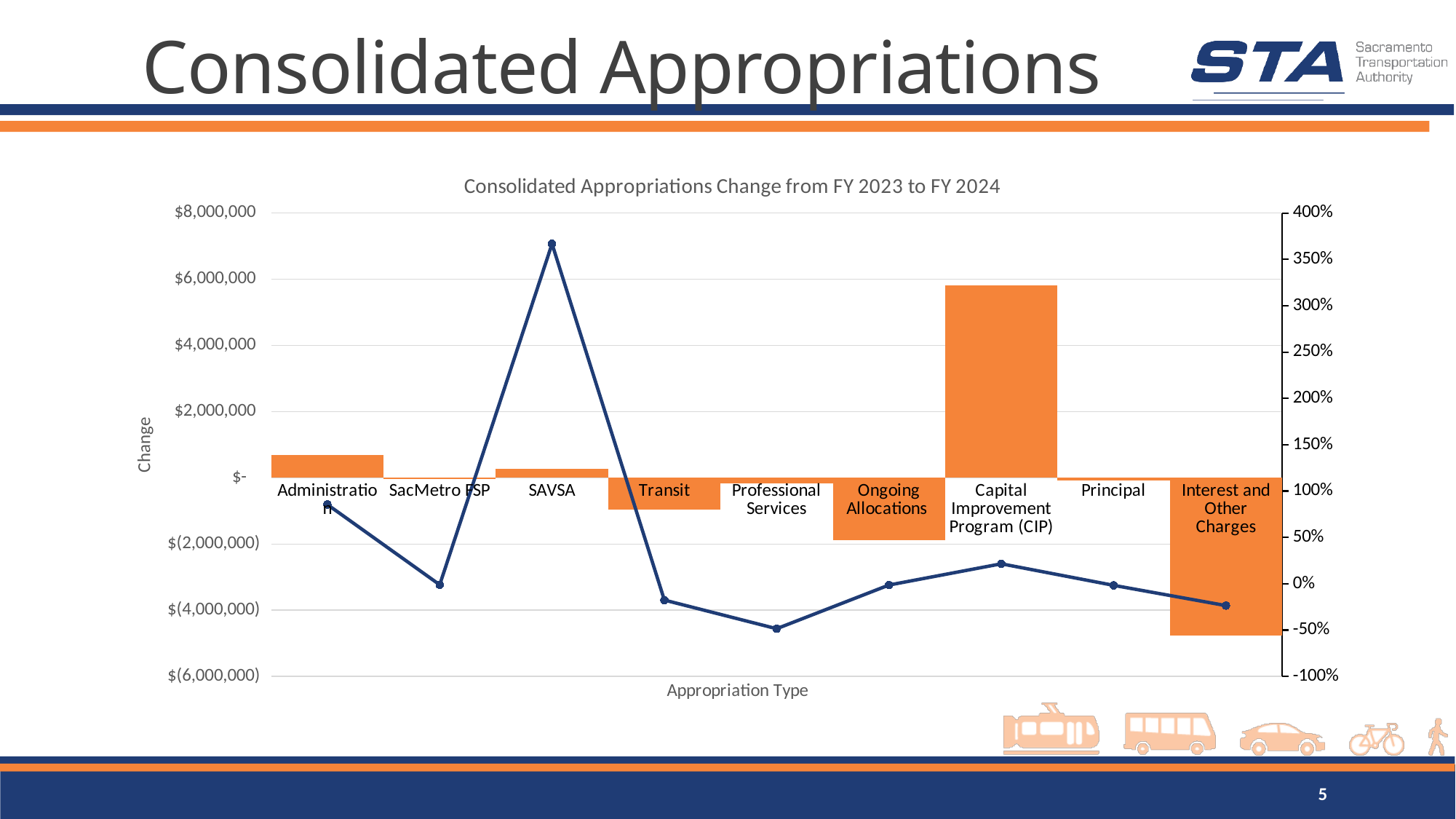
Is the line value for SAVSA greater or less than 300%? greater What is the title of the chart? Consolidated Appropriations Change from FY 2023 to FY 2024 Which appropriation type has the lowest bar (most negative dollar change)? Interest and Other Charges What is the label of the x axis? Appropriation Type Which appropriation type has the highest point on the line (percent change)? SAVSA What kind of chart is shown on the slide? Combined bar and line chart Which has the larger bar value, Transit or Ongoing Allocations? Transit Is the bar value for Administration greater or less than $2,000,000? less Is the bar value for Capital Improvement Program (CIP) greater or less than $4,000,000? greater How many appropriation types are shown on the x axis? 9 Which appropriation type has the lowest point on the line (percent change)? Professional Services Which appropriation type has the highest bar (largest dollar change)? Capital Improvement Program (CIP)